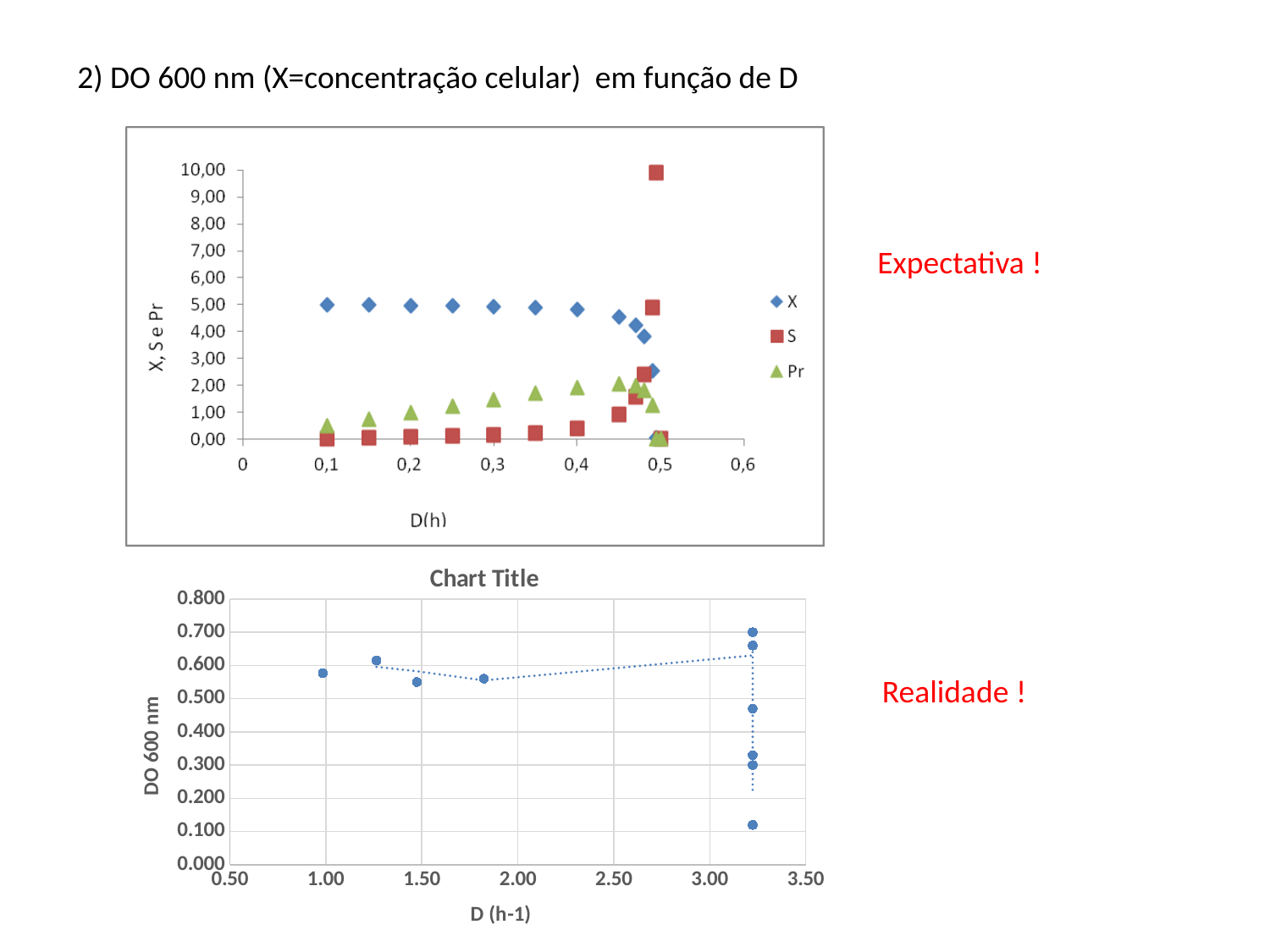
What kind of chart is the top chart (X, S e Pr versus D(h))? scatter chart In the top chart, is the value of S at D = 0.3 greater or less than 1.00? less How many series does the legend of the top chart list? 3 What is the title of the bottom chart? Chart Title In the top chart, do the Pr values rise or fall as D increases from 0.1 to 0.4? rise In the top chart, at D = 0.1, which series has the larger value, X or Pr? X In the bottom chart, is the DO 600 nm value at D = 1.00 greater or less than 0.500? greater In the top chart, is the value of X at D = 0.1 greater or less than 4.00? greater What kind of chart is the bottom chart (DO 600 nm versus D (h-1))? scatter chart In the top chart, which series reaches the highest plotted value? S What are the legend entries of the top chart? X, S, Pr